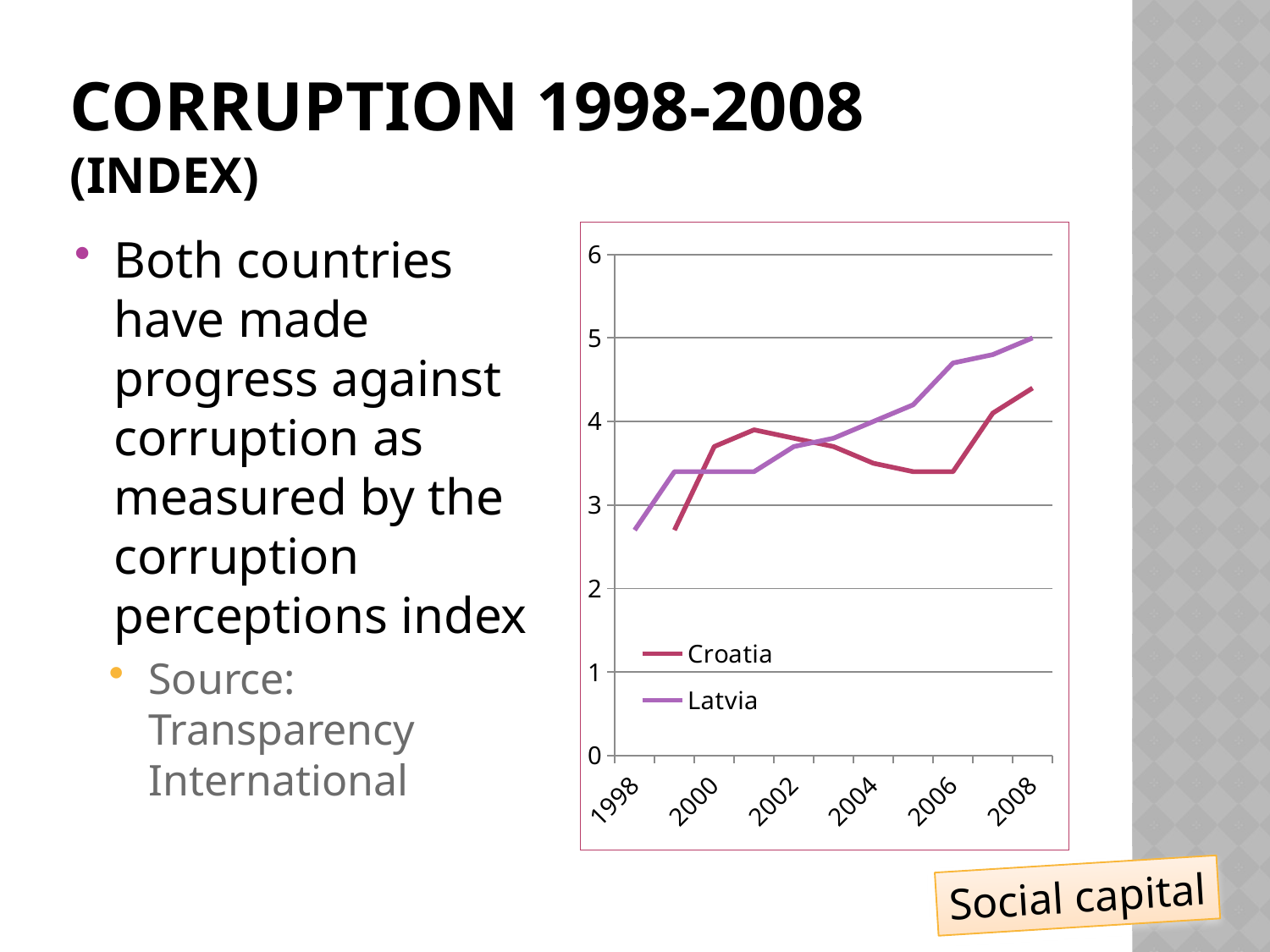
In 2008, which series has the higher value, Croatia or Latvia? Latvia Is the value for Croatia in 2008 greater or less than 4? greater Is the value for Latvia in 1998 greater or less than 3? less How many series does the chart's legend list? 2 What colour is the line for Latvia? purple In 2006, which series has the higher value, Croatia or Latvia? Latvia Which two series are listed in the chart's legend? Croatia and Latvia How many year labels are shown on the x axis? 6 What kind of chart is shown on the slide? line chart Is the value for Latvia in 2006 greater or less than 4? greater Does the Latvia line generally rise or fall from 1998 to 2008? rise